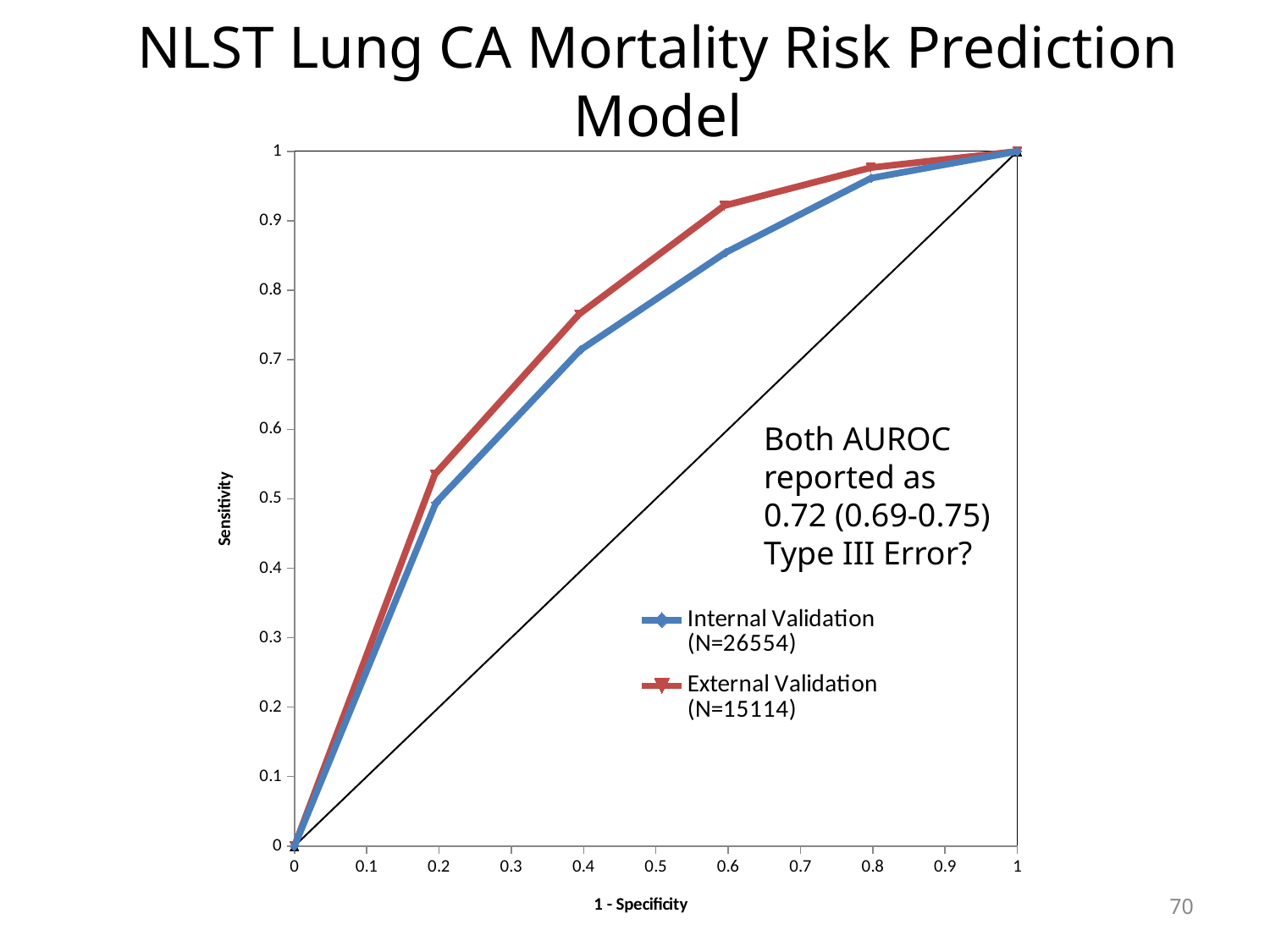
What is the label of the y axis? Sensitivity What is the sensitivity of the External Validation series at 1 - Specificity of 1? 1 How many series does the chart legend list? 2 What kind of chart is shown on the slide? line chart Do the Internal Validation values rise or fall as 1 - Specificity increases from 0 to 1? rise What is the sensitivity of the Internal Validation series at 1 - Specificity of 0? 0 Is the sensitivity for External Validation at 1 - Specificity of 0.4 greater or less than 0.7? greater At 1 - Specificity of 0.4, which series has the higher sensitivity, Internal Validation or External Validation? External Validation What are the two series named in the legend? Internal Validation (N=26554) and External Validation (N=15114) Is the sensitivity for Internal Validation at 1 - Specificity of 0.8 greater or less than 0.9? greater Is the sensitivity for Internal Validation at 1 - Specificity of 0.6 greater or less than 0.8? greater How many data points are plotted for the Internal Validation series? 6